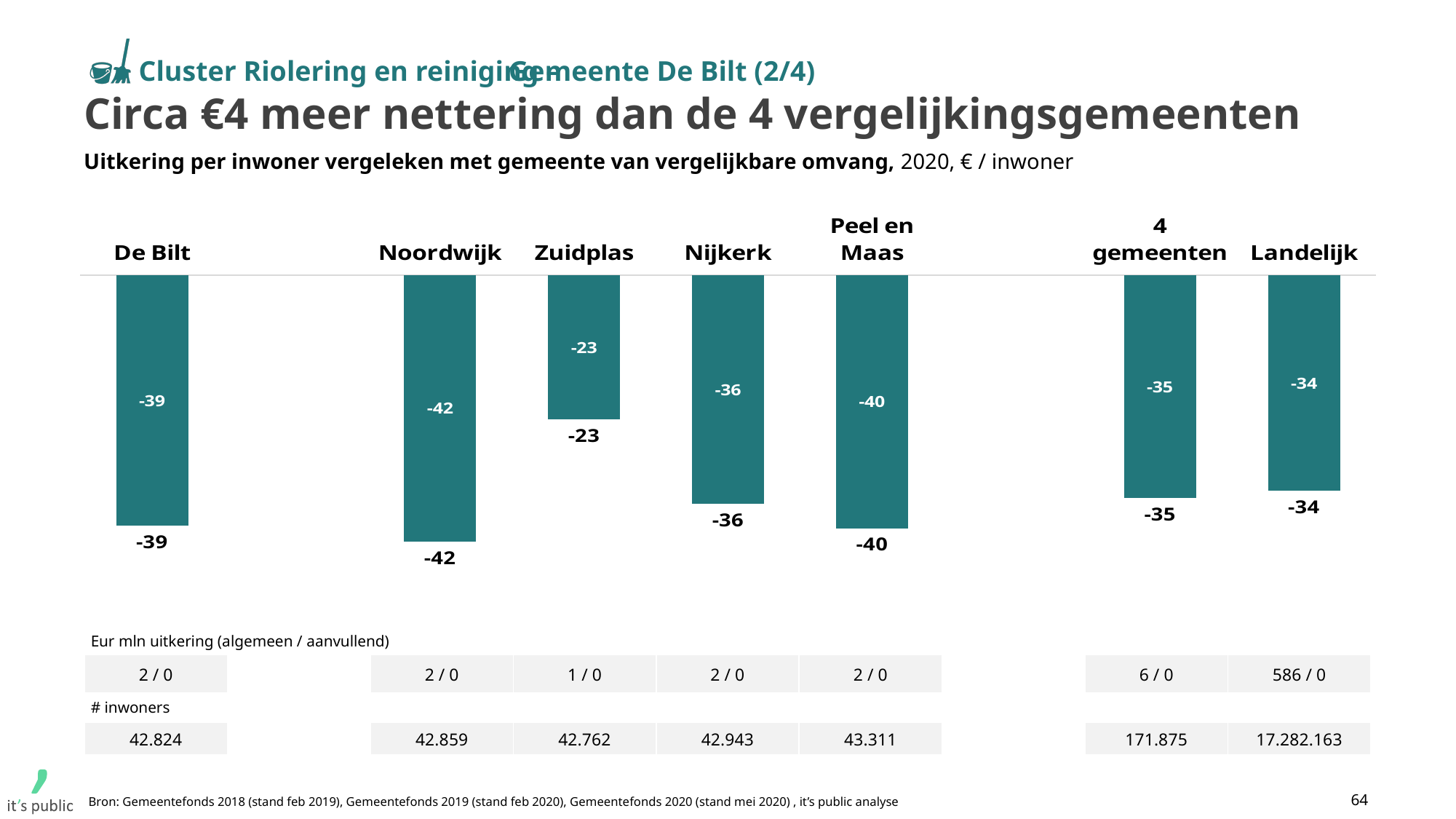
What is the value shown for Peel en Maas? -40 How many categories are shown in the chart? 7 Which has the lower value, Nijkerk or Peel en Maas? Peel en Maas What is the value shown for De Bilt? -39 What is the difference between the values for De Bilt and 4 gemeenten? 4 What is the difference between the values for Noordwijk and Zuidplas? 19 Which category has the bar extending furthest below zero (the lowest value)? Noordwijk Which category has the highest (least negative) value? Zuidplas What is the value shown for Landelijk? -34 What is the value shown for Zuidplas? -23 What unit is stated in the chart subtitle for the values? € / inwoner What kind of chart is shown on the slide? Bar chart